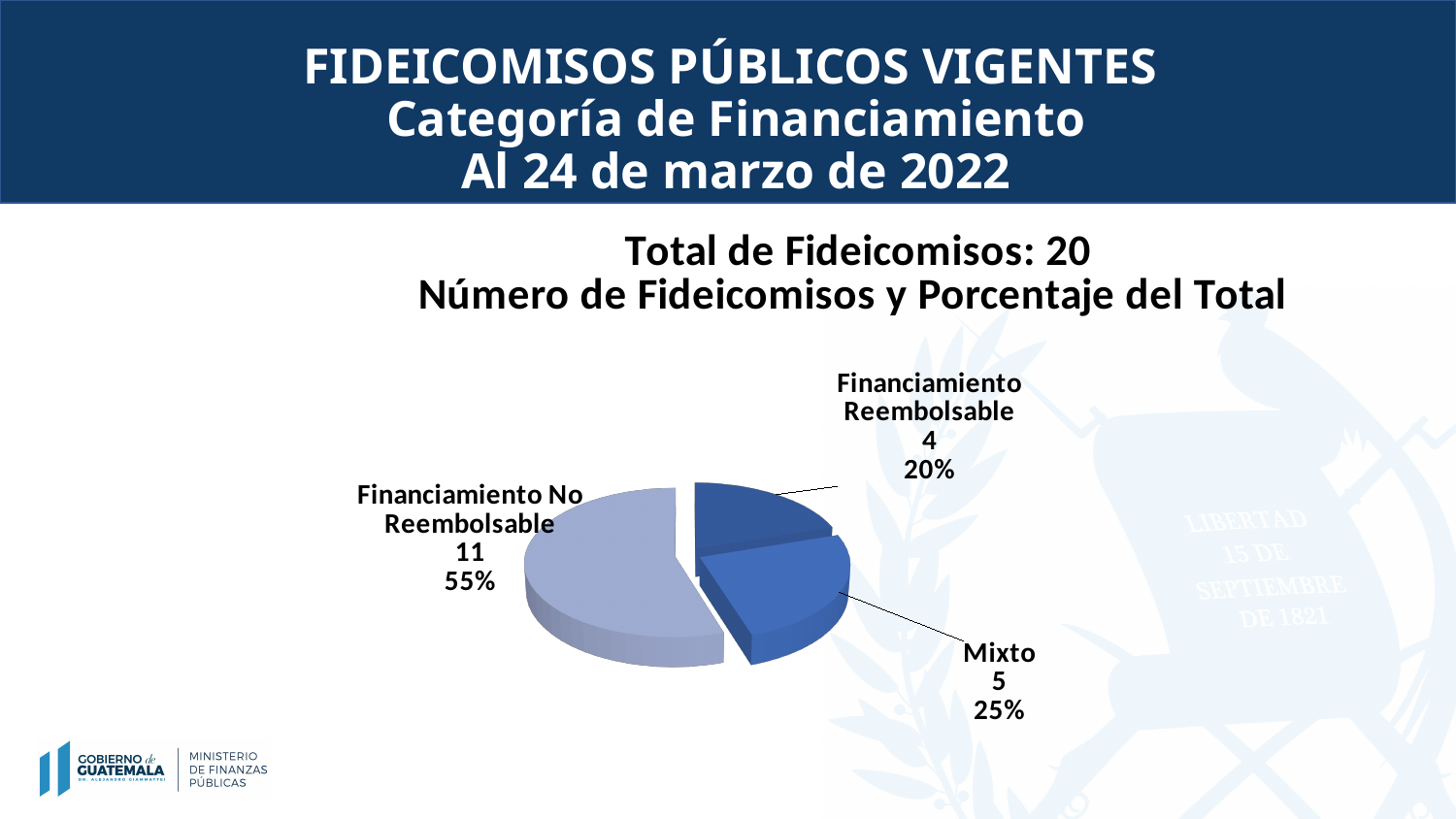
How many fideicomisos are in the Financiamiento No Reembolsable category? 11 How many fideicomisos are in the Financiamiento Reembolsable category? 4 What percentage of the total does Mixto represent? 25% Which category has the smallest share of the pie? Financiamiento Reembolsable What percentage of the total does Financiamiento Reembolsable represent? 20% What kind of chart is shown on the slide? Pie chart What is the difference in the number of fideicomisos between Financiamiento No Reembolsable and Mixto? 6 Which category has the largest share of the pie? Financiamiento No Reembolsable How many categories does the pie chart show? 3 What is the total number of fideicomisos stated on the slide? 20 What percentage of the total does Financiamiento No Reembolsable represent? 55% Which has more fideicomisos, Mixto or Financiamiento Reembolsable? Mixto